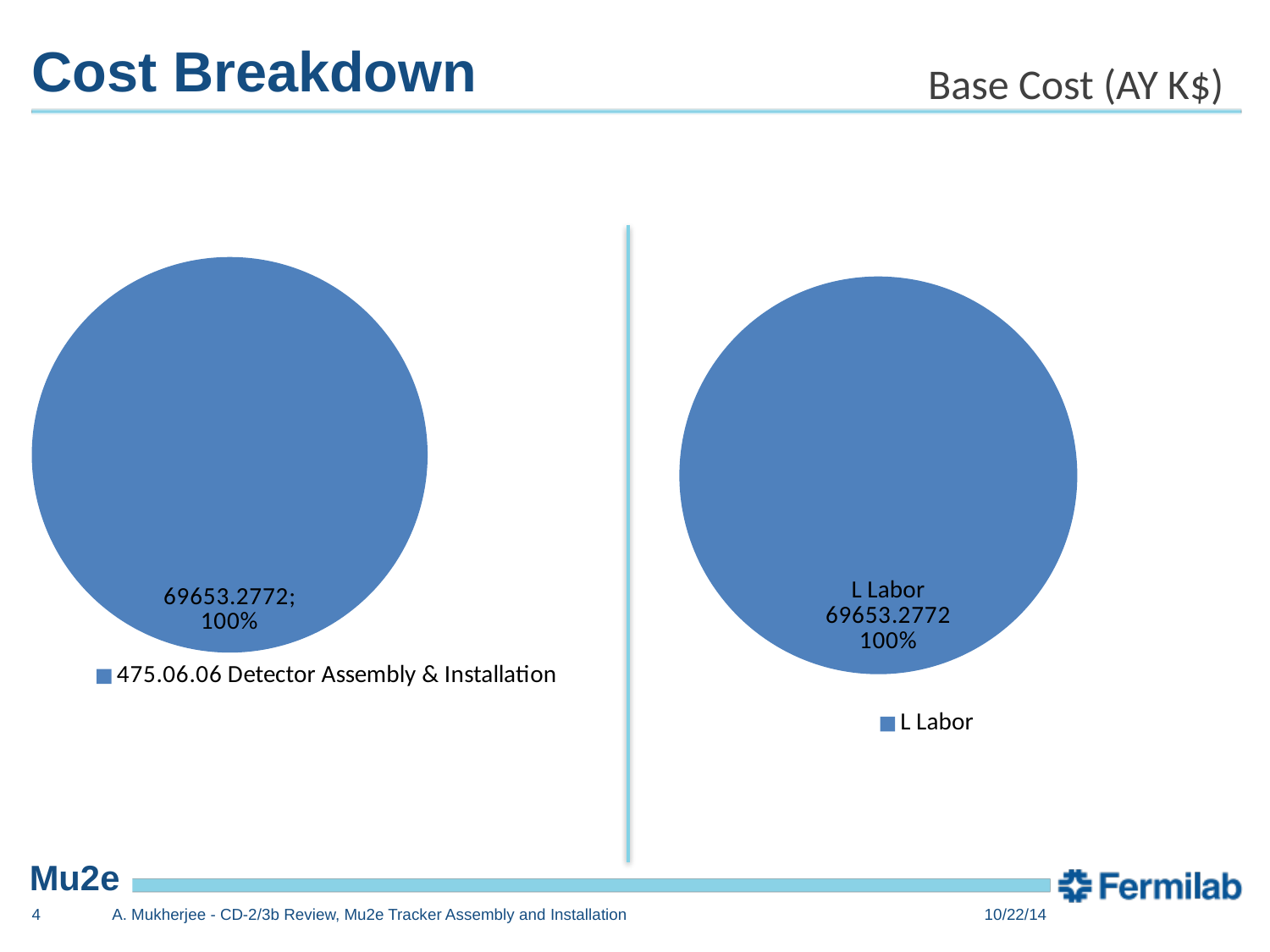
What is the legend entry of the right pie chart? L Labor In the left pie chart, what value is shown for 475.06.06 Detector Assembly & Installation? 69653.2772 How many slices does the left pie chart have? 1 How many entries does the legend of the right pie chart list? 1 How many slices does the right pie chart have? 1 What kind of chart is the left chart on the slide? pie chart How many entries does the legend of the left pie chart list? 1 In the right pie chart, what share of the pie does L Labor take? 100% In the right pie chart, what value is shown for L Labor? 69653.2772 In the left pie chart, what share of the pie does 475.06.06 Detector Assembly & Installation take? 100% What is the legend entry of the left pie chart? 475.06.06 Detector Assembly & Installation What kind of chart is the right chart on the slide? pie chart